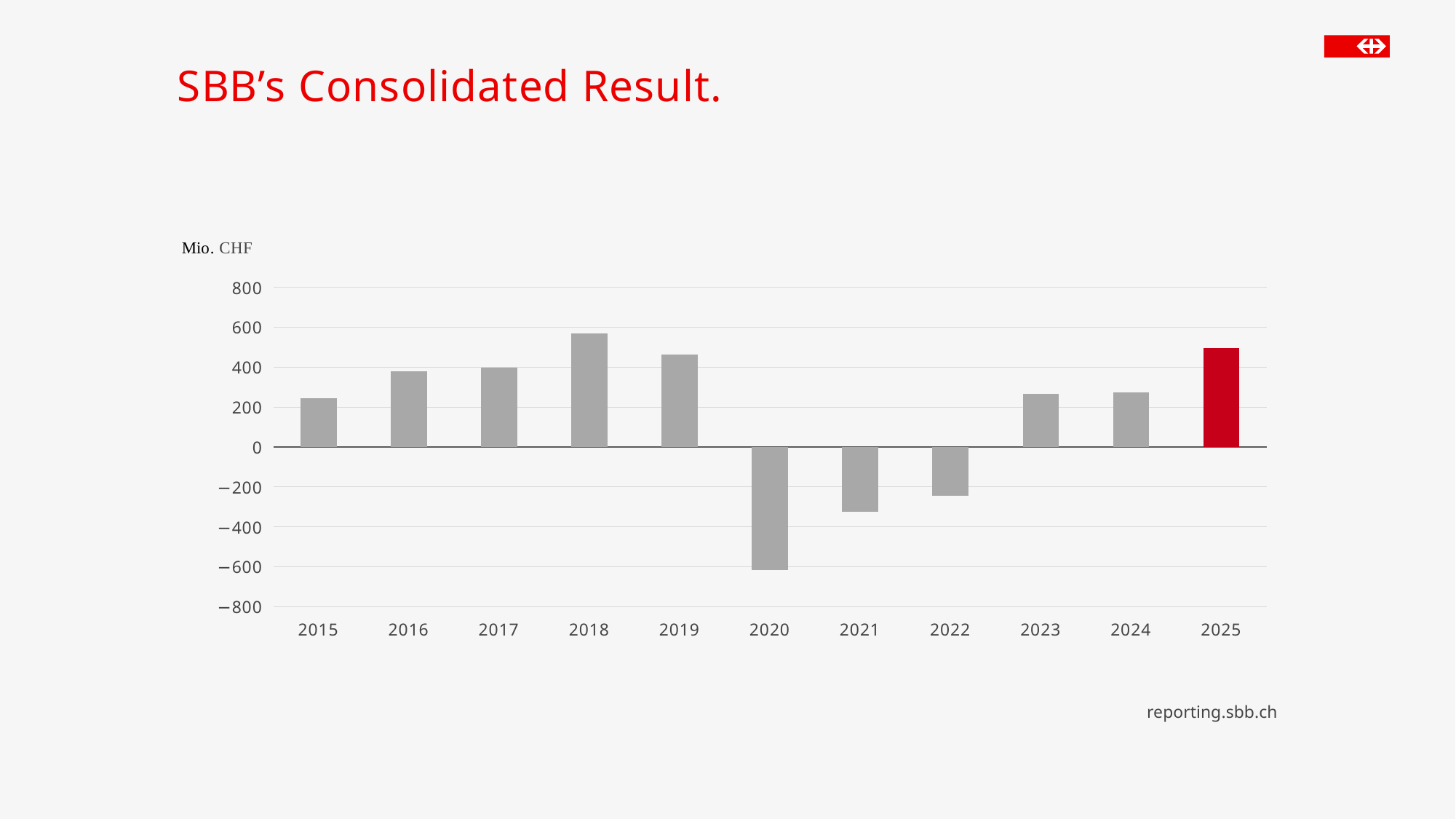
Is the value for 2025 greater or less than 400? greater Which year has the highest consolidated result? 2018 Which year's bar is highlighted in red? 2025 Is the value for 2018 greater or less than 400? greater Which year has the larger consolidated result, 2018 or 2019? 2018 Which year has the larger consolidated result, 2021 or 2022? 2022 Do the values rise or fall from 2015 to 2018? rise How many years are shown on the x axis of the chart? 11 Is the value for 2015 greater or less than 400? less Which year has the lowest consolidated result? 2020 What kind of chart is shown on the slide? bar chart